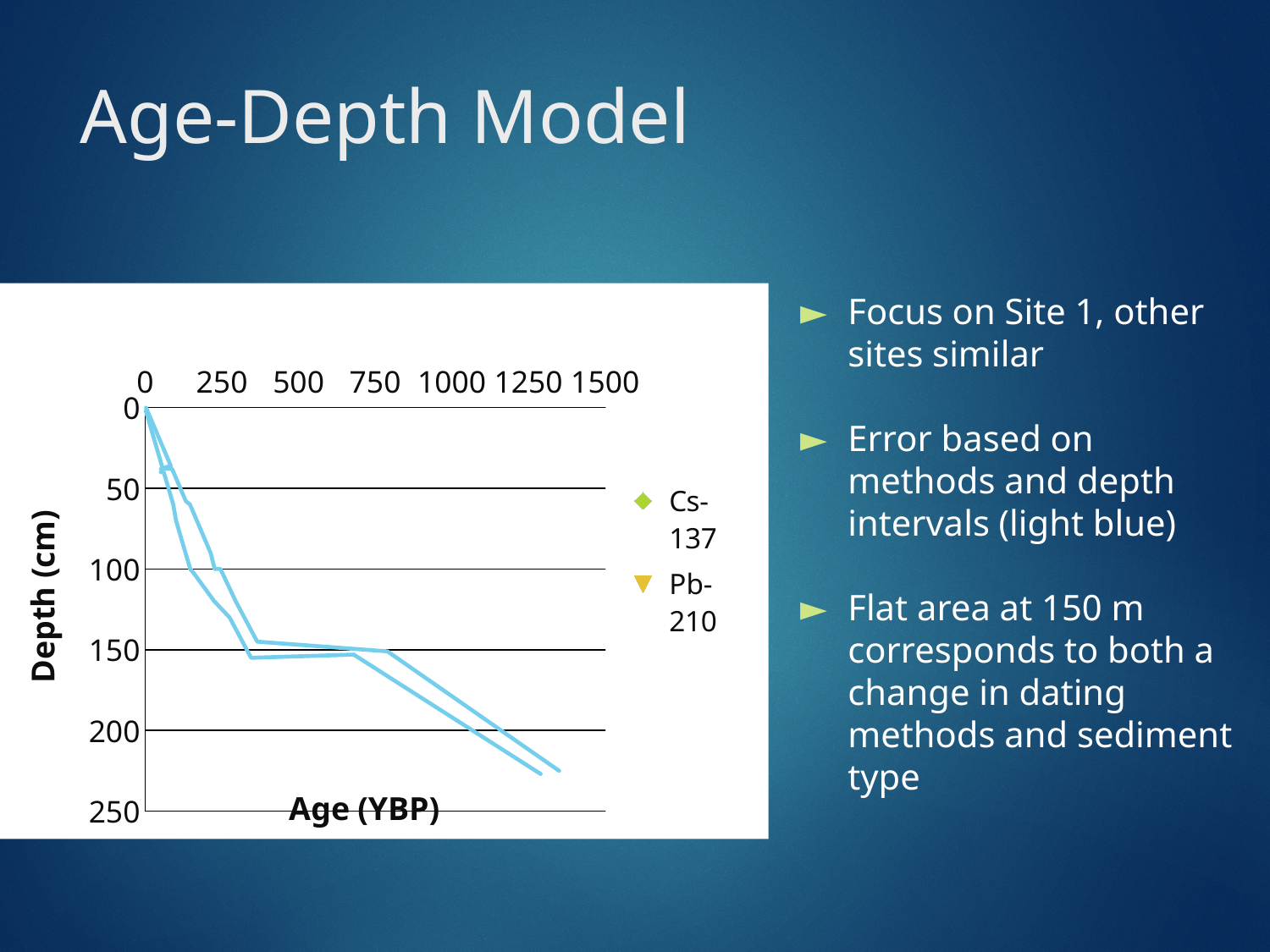
As age increases along the x axis, does the plotted depth increase or decrease? increase How many tick labels are shown on the chart's Age (YBP) axis? 7 How many series does the chart's legend list? 2 How many tick labels are shown on the chart's Depth (cm) axis? 6 Is the greatest age reached by the plotted lines greater or less than 1250 YBP? greater What is the largest value shown on the chart's Age (YBP) axis? 1500 What is the largest value shown on the chart's Depth (cm) axis? 250 What kind of chart is shown on the slide? line chart What are the two series named in the chart's legend? Cs-137 and Pb-210 What is the title of the chart's vertical axis? Depth (cm) What is the title of the chart's horizontal axis? Age (YBP) Is the greatest depth reached by the plotted lines greater or less than 200 cm? greater